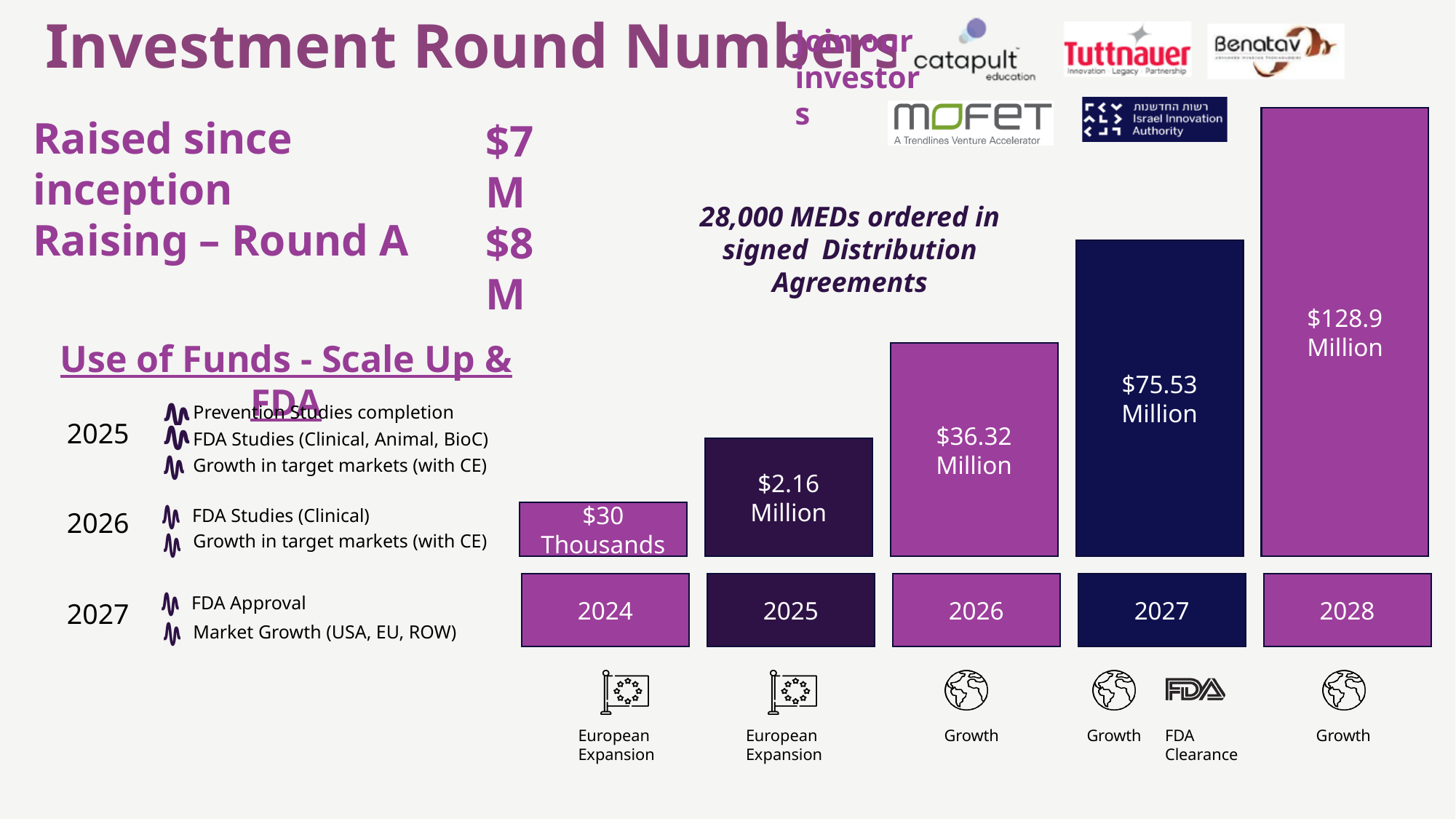
What value is shown for 2027 in the bar chart? $75.53 Million Which year has the lowest value in the bar chart? 2024 What value is shown for 2028 in the bar chart? $128.9 Million What value is shown for 2026 in the bar chart? $36.32 Million What value is shown for 2024 in the bar chart? $30 Thousands What is the difference between the 2028 and 2027 values in the bar chart? $53.37 Million How many years are shown as bars in the chart? 5 Which year has the highest value in the bar chart? 2028 What is the difference between the 2027 and 2026 values in the bar chart? $39.21 Million What kind of chart is used to show the values from 2024 to 2028? Bar chart What value is shown for 2025 in the bar chart? $2.16 Million Which is larger in the bar chart, the value for 2026 or the value for 2025? 2026